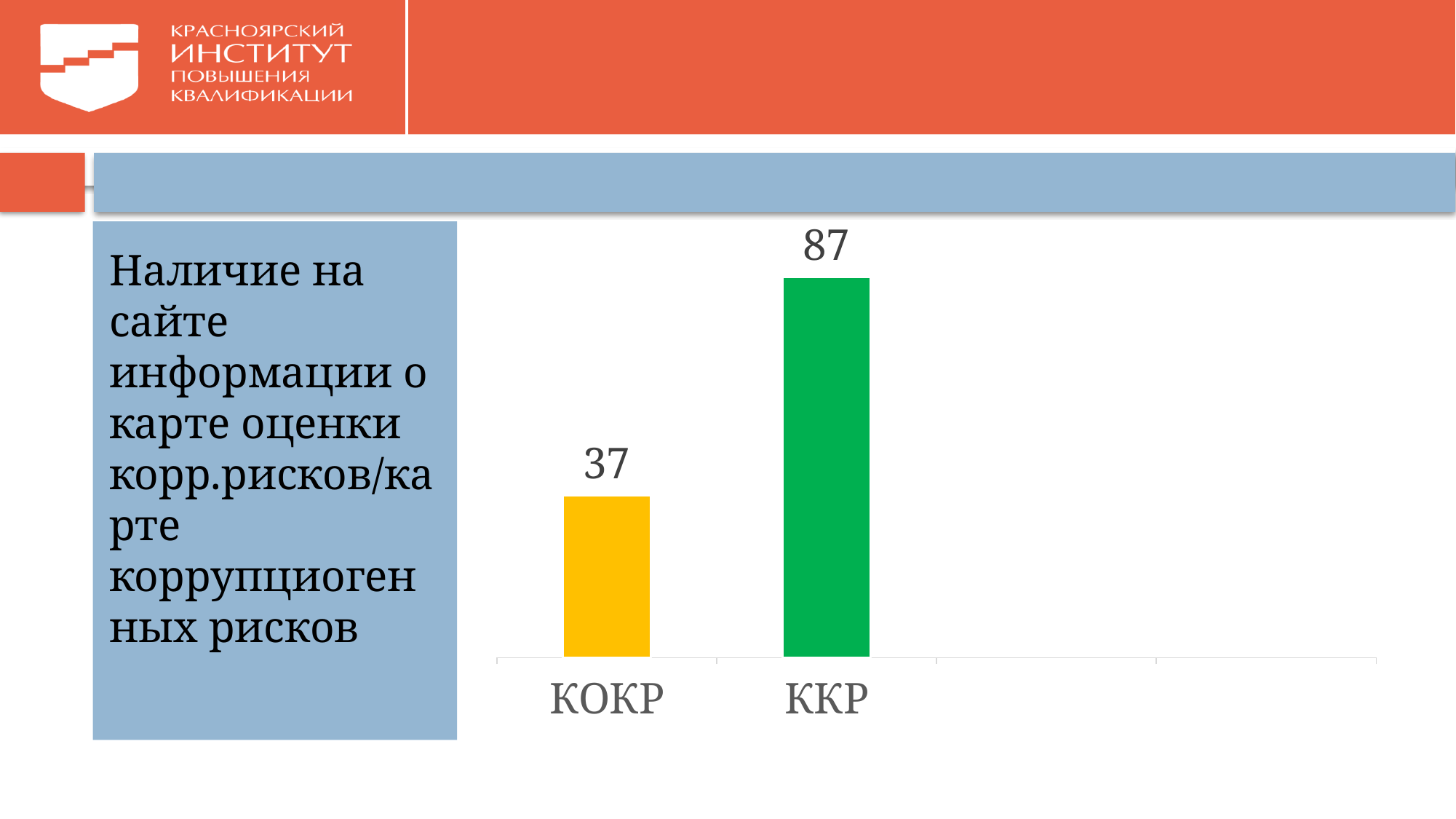
Which category has the highest value? ККР What colour is the bar for КОКР? yellow Which is larger, the value for КОКР or the value for ККР? ККР What is the value for ККР? 87 What is the total of the two bars in the chart? 124 What kind of chart is shown on the slide? bar chart What is the difference between the values for ККР and КОКР? 50 What colour is the bar for ККР? green How many categories are shown in the chart? 2 Which category has the lowest value? КОКР What is the value for КОКР? 37